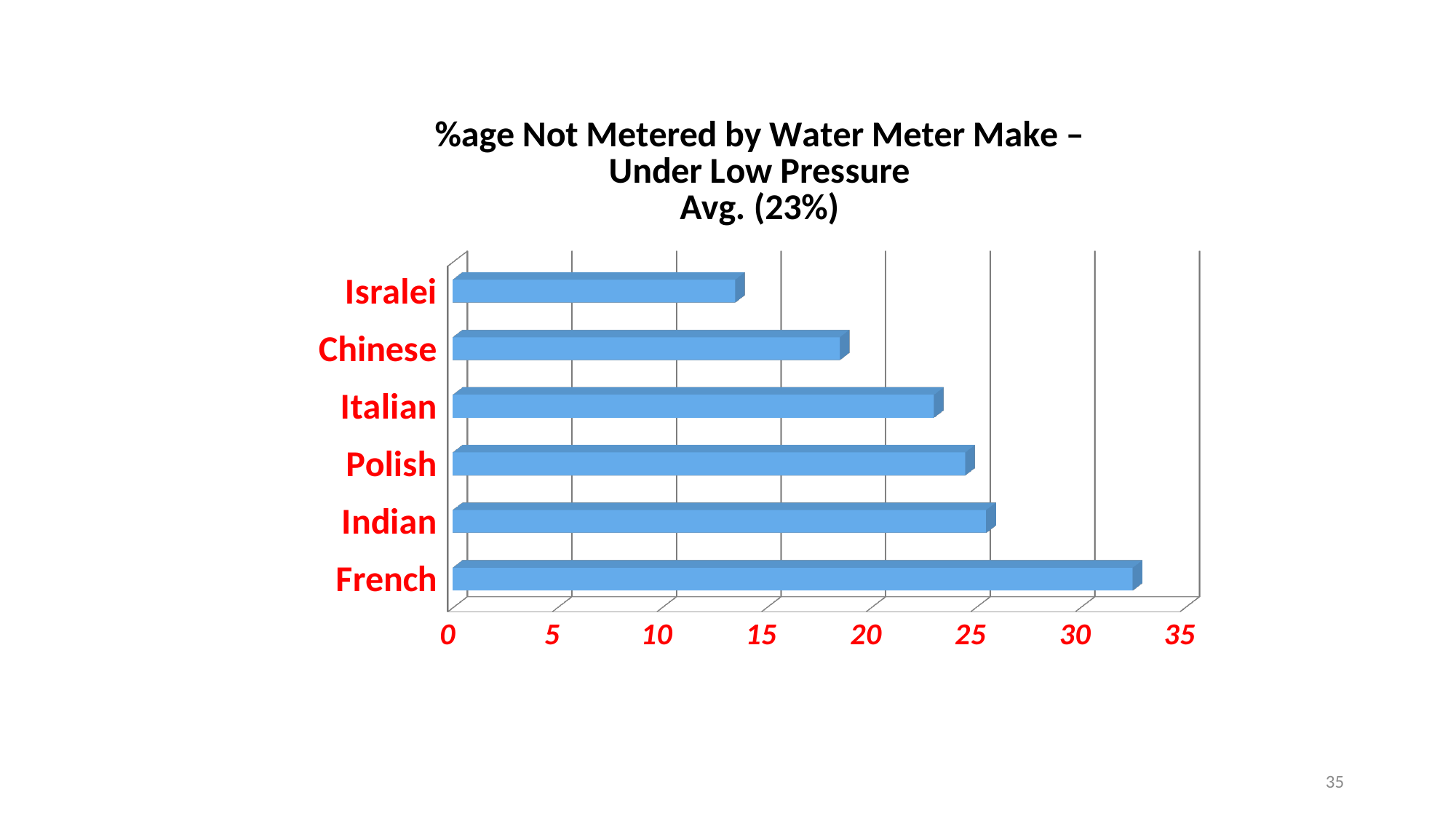
Which has a larger percentage not metered, Chinese or Italian? Italian Is the value for Indian greater or less than 20? greater How many water meter makes are shown in the chart? 6 What kind of chart is shown on the slide? bar chart Which water meter make has the highest percentage not metered? French Is the value for Chinese greater or less than 20? less Is the value for Isralei greater or less than 15? less Which water meter make has the lowest percentage not metered? Isralei What average percentage is stated in the chart title? 23% Which has a larger percentage not metered, French or Polish? French